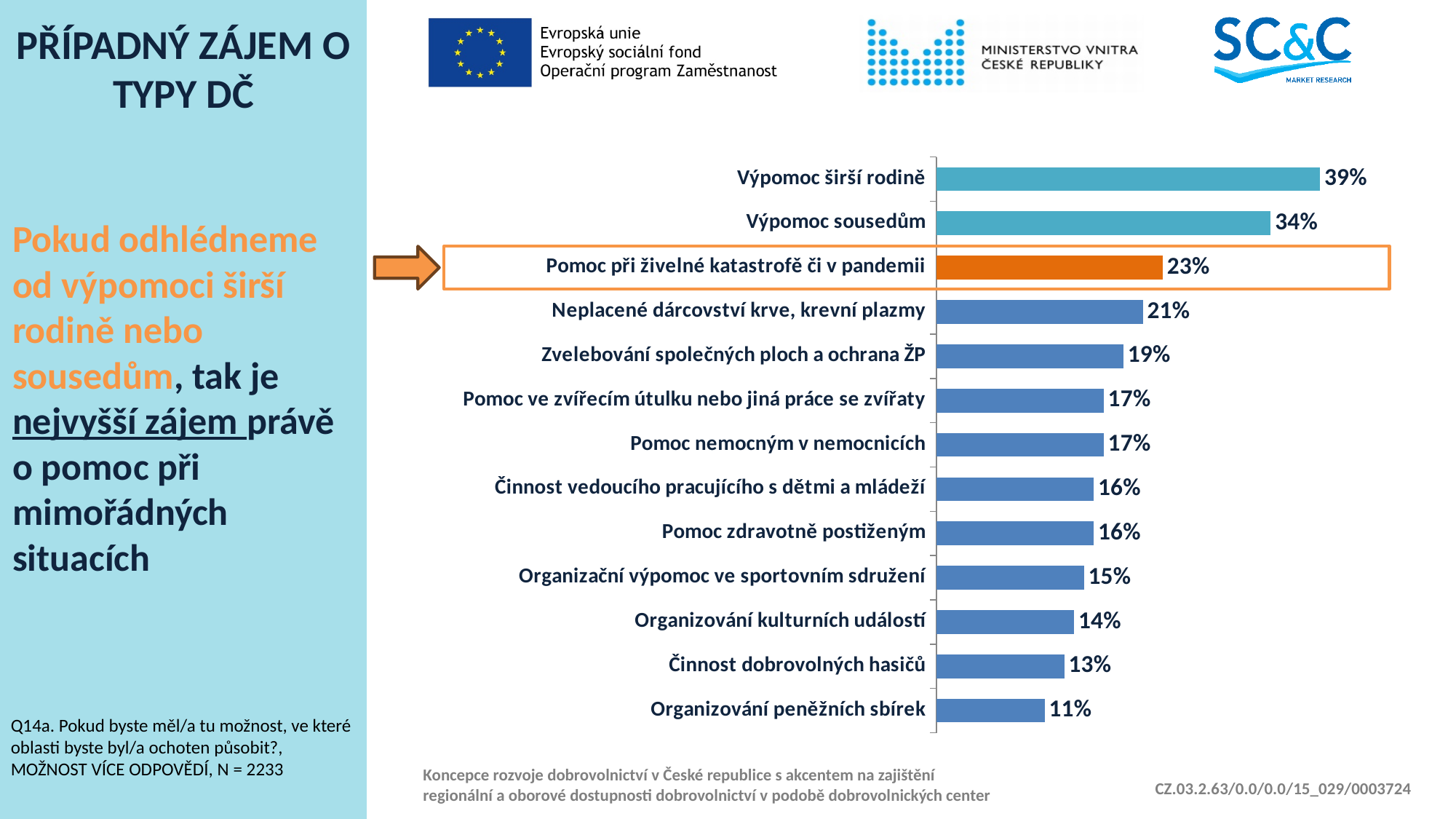
How many categories are shown in the chart? 13 What is the value for Činnost dobrovolných hasičů? 13% What is the difference between Výpomoc širší rodině and Výpomoc sousedům? 5% What kind of chart is shown on the slide? Bar chart What is the difference between Pomoc při živelné katastrofě či v pandemii and Neplacené dárcovství krve, krevní plazmy? 2% Which is larger: Zvelebování společných ploch a ochrana ŽP or Organizování kulturních událostí? Zvelebování společných ploch a ochrana ŽP Which category has the highest value? Výpomoc širší rodině Which bar is highlighted in orange? Pomoc při živelné katastrofě či v pandemii Which category has the lowest value? Organizování peněžních sbírek What is the value for Výpomoc širší rodině? 39% What is the value for Pomoc při živelné katastrofě či v pandemii? 23% What is the value for Organizování peněžních sbírek? 11%